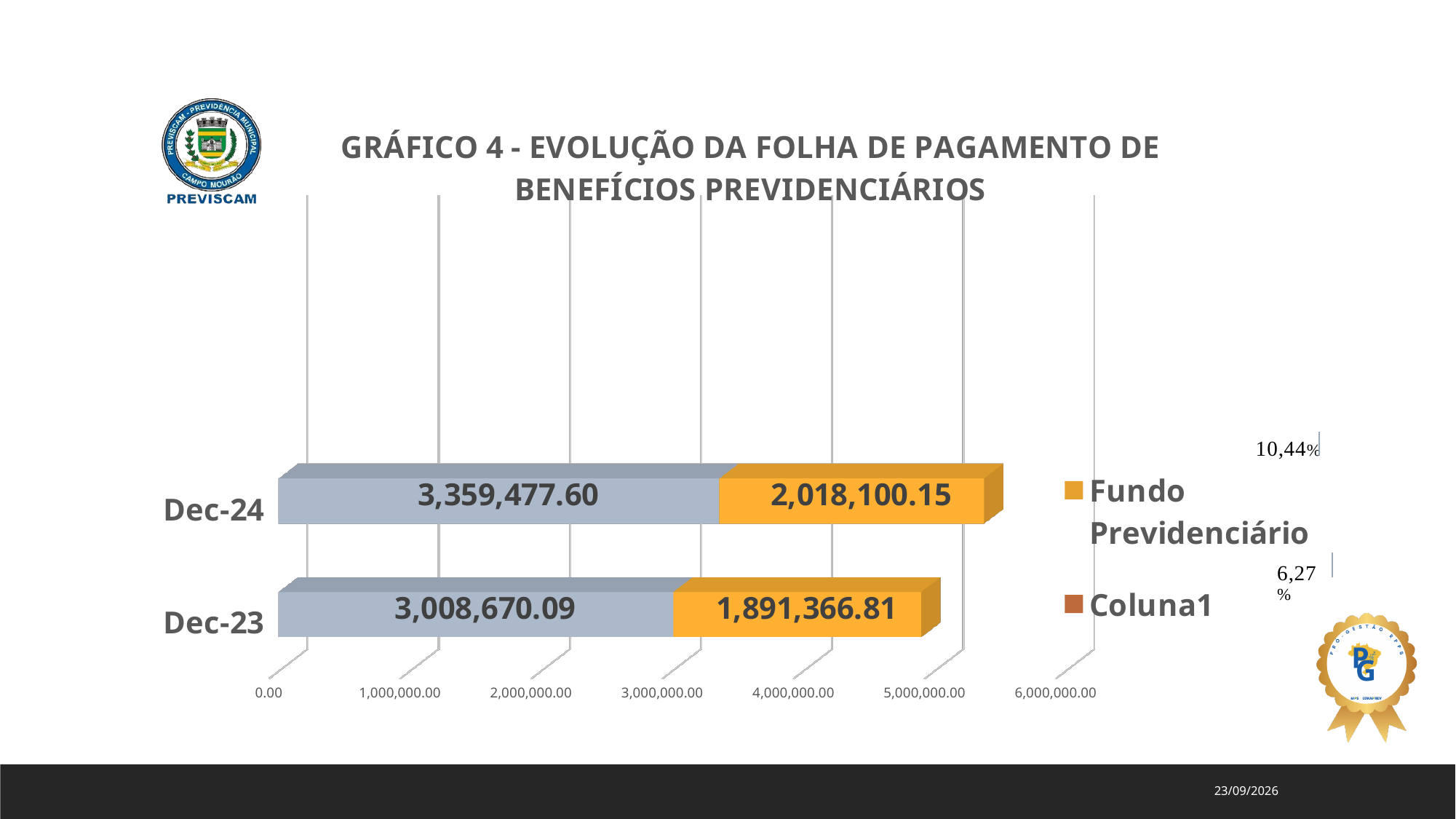
What is the total of the stacked bar for Dec-24? 5,377,577.75 What is the value of the gray segment for Dec-24? 3,359,477.60 What is the value of the orange segment for Dec-24? 2,018,100.15 What is the total of the stacked bar for Dec-23? 4,900,036.90 How many categories are shown on the vertical axis of the chart? 2 What is the value of the gray segment for Dec-23? 3,008,670.09 How many series does the chart legend list? 2 What type of chart is shown on the slide? Bar chart What is the title of the chart? GRÁFICO 4 - EVOLUÇÃO DA FOLHA DE PAGAMENTO DE BENEFÍCIOS PREVIDENCIÁRIOS What is the value of the orange segment for Dec-23? 1,891,366.81 Which category has the larger orange segment, Dec-24 or Dec-23? Dec-24 What is the difference between the gray segment values for Dec-24 and Dec-23? 350,807.51